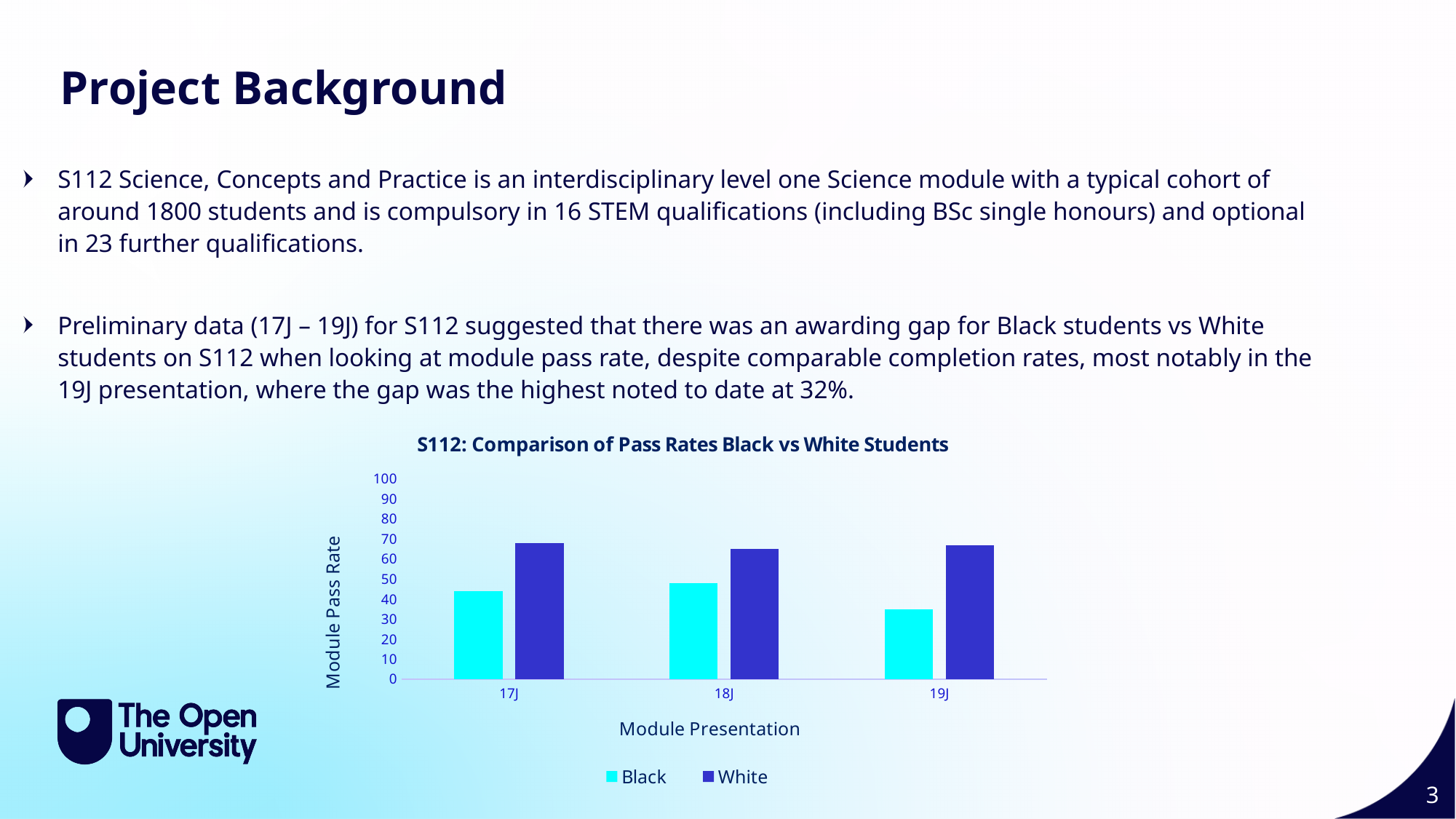
What kind of chart is shown on the slide? Bar chart Which series has the higher pass rate in 17J, Black or White? White Is the Black pass rate for 18J greater or less than 40? greater In which module presentation is the Black pass rate lowest? 19J What is the title of the chart? S112: Comparison of Pass Rates Black vs White Students Which series has the higher pass rate in 19J, Black or White? White Is the White pass rate for 17J greater or less than 60? greater How many module presentations are shown on the x axis? 3 How many series does the chart legend list? 2 What is the label of the y axis? Module Pass Rate In which module presentation is the Black pass rate highest? 18J Is the Black pass rate for 19J greater or less than 40? less